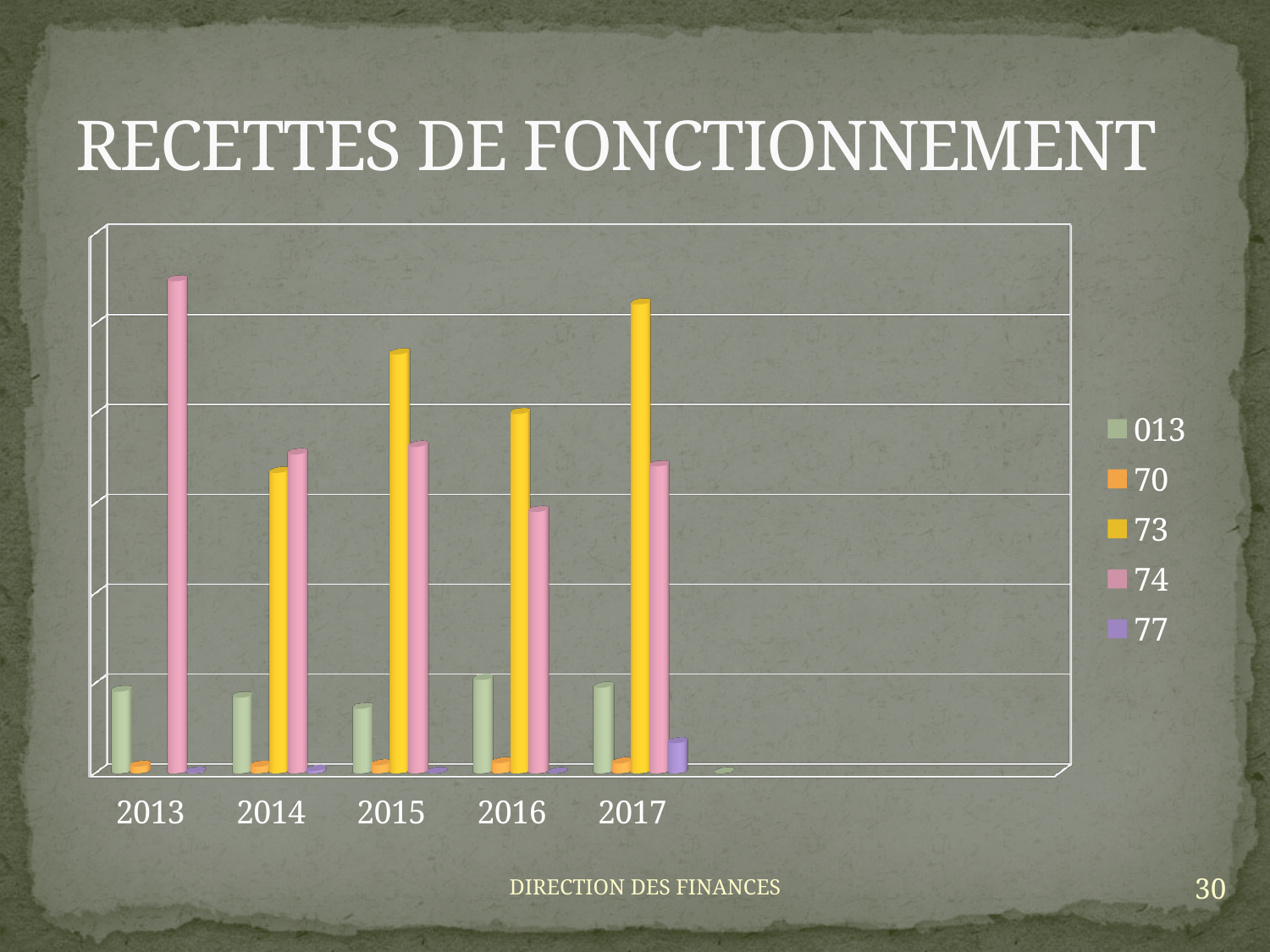
What kind of chart is shown on the slide? Bar chart In 2013, which series has the tallest bar? 74 In which year is the bar for series 73 the highest? 2017 In 2017, which series has the tallest bar? 73 In 2017, which series has the smallest bar? 70 In which year is the bar for series 74 the lowest? 2016 How many series does the chart legend list? 5 Is the bar for series 73 larger in 2015 or in 2016? 2015 What is the title of the chart on the slide? RECETTES DE FONCTIONNEMENT Is the bar for series 74 larger in 2013 or in 2017? 2013 Which series is represented by the yellow bars in the chart? 73 How many years are shown on the x axis of the chart? 5